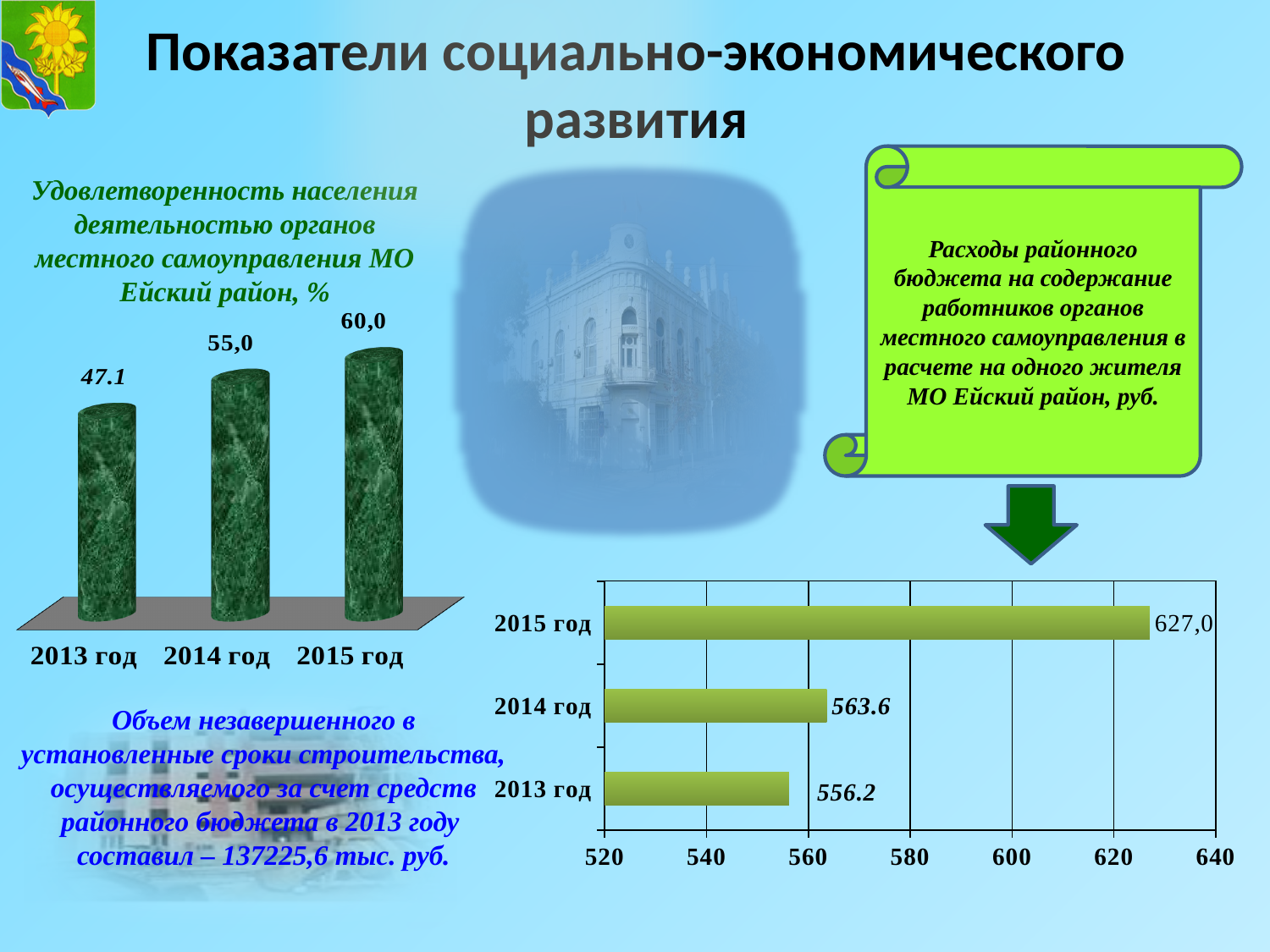
What kind of chart is the bottom-right chart (Расходы районного бюджета ...)? bar chart On the left chart (Удовлетворенность населения ...), how many years are shown? 3 On the left chart (Удовлетворенность населения ...), do the values rise or fall from 2013 год to 2015 год? rise On the left chart (Удовлетворенность населения ...), what is the value for 2015 год? 60,0 On the bottom-right chart (Расходы районного бюджета ...), which year has the highest value? 2015 год On the bottom-right chart (Расходы районного бюджета на содержание работников органов местного самоуправления в расчете на одного жителя), what is the value for 2014 год? 563.6 On the bottom-right chart (Расходы районного бюджета ...), what is the value for 2015 год? 627,0 On the left chart (Удовлетворенность населения ...), what is the difference between the values for 2015 год and 2013 год? 12.9 On the left chart (Удовлетворенность населения ...), which year has the lowest value? 2013 год On the bottom-right chart (Расходы районного бюджета ...), is the value for 2013 год greater or less than 560? less On the left chart (Удовлетворенность населения деятельностью органов местного самоуправления МО Ейский район, %), what is the value for 2013 год? 47.1 On the bottom-right chart (Расходы районного бюджета ...), what is the difference between the values for 2015 год and 2013 год? 70.8